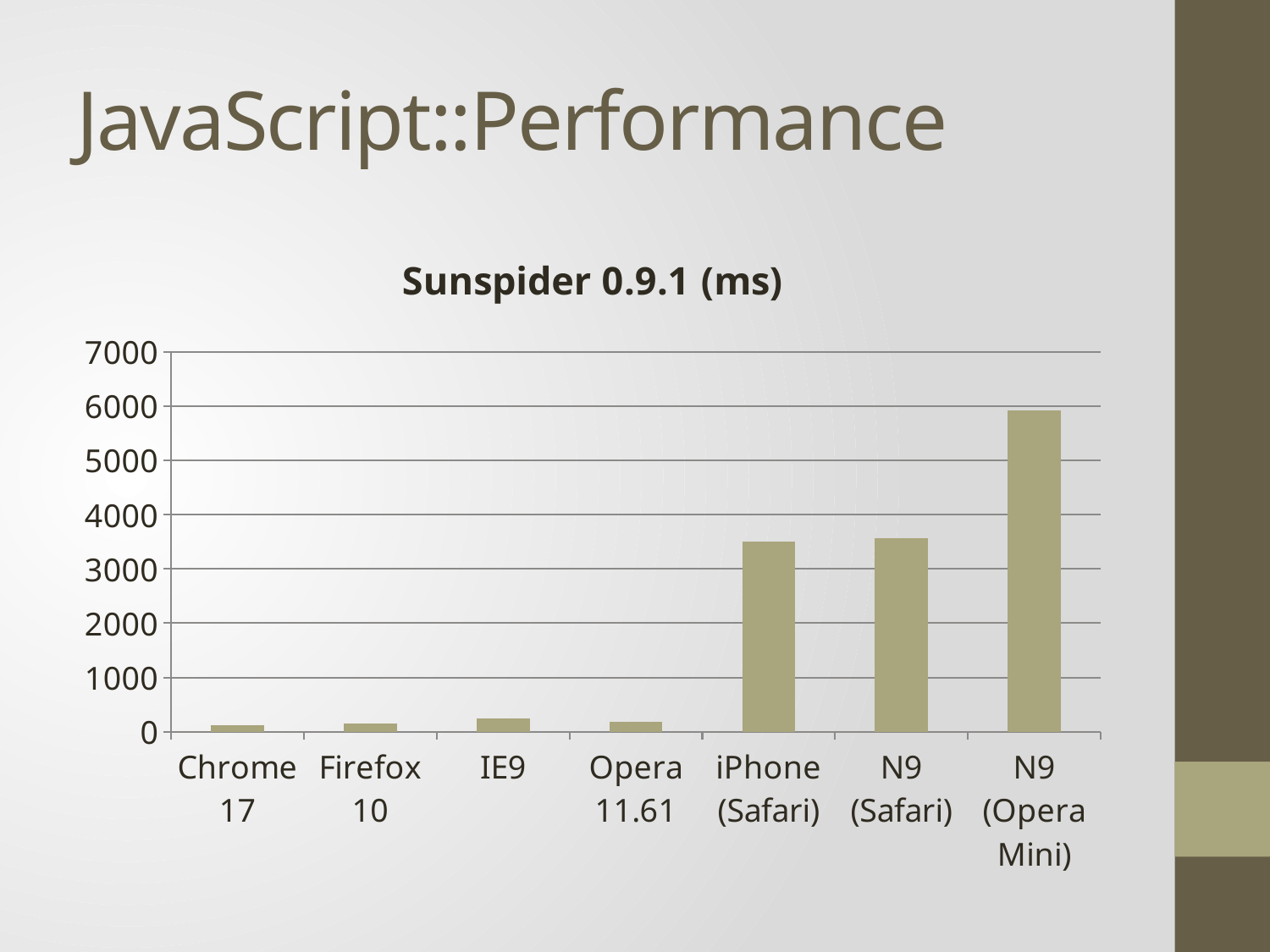
Is the value for Chrome 17 greater or less than 1000? less Which has the larger value, N9 (Opera Mini) or iPhone (Safari)? N9 (Opera Mini) Which category has the highest value? N9 (Opera Mini) Is the value for N9 (Safari) greater or less than 4000? less Is the value for iPhone (Safari) greater or less than 3000? greater How many browsers/categories are plotted on the x axis? 7 What is the highest value shown on the y axis? 7000 What kind of chart is shown on the slide? bar chart Which has the larger value, IE9 or Chrome 17? IE9 What is the title of the chart? Sunspider 0.9.1 (ms)